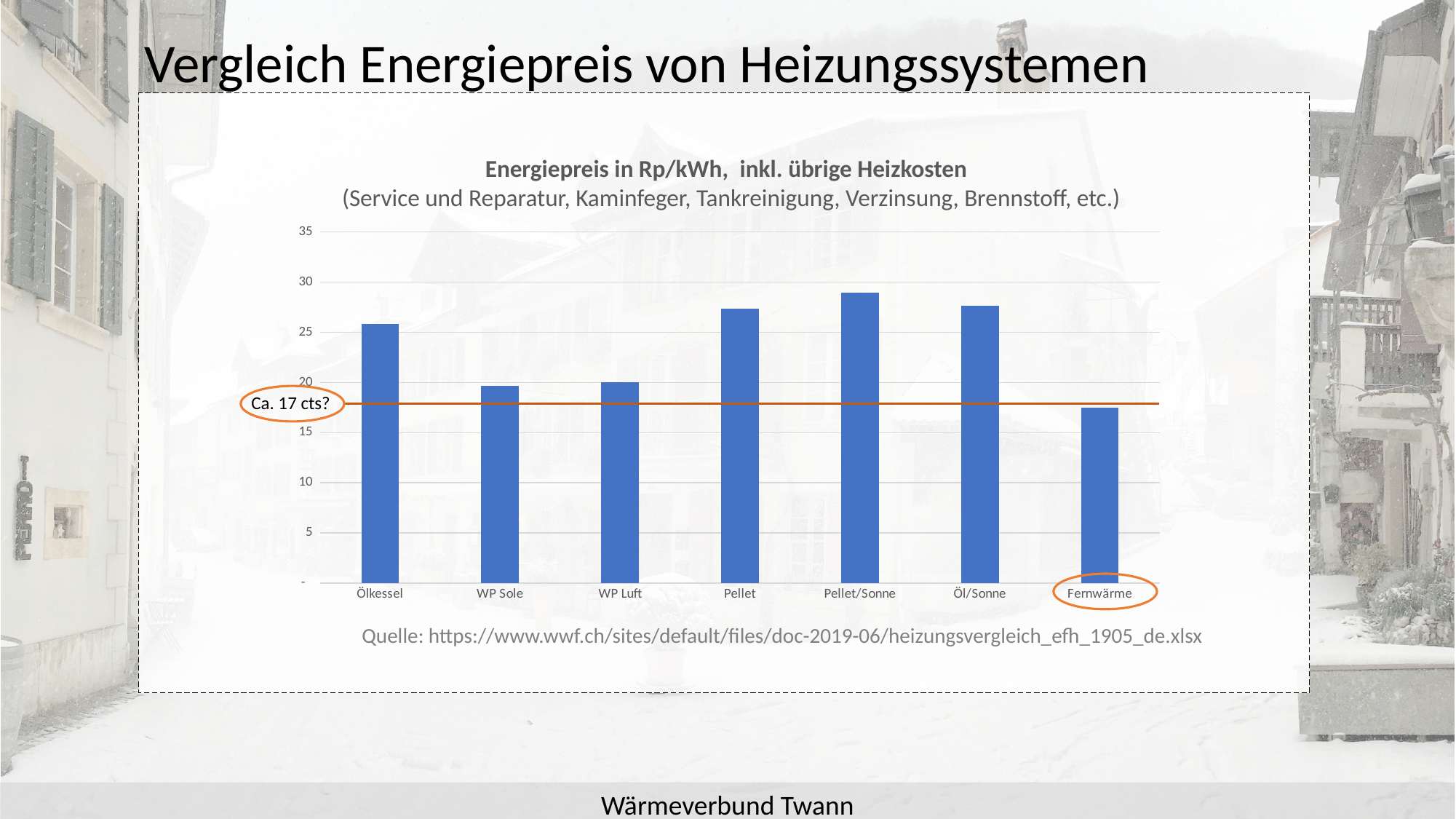
What text is written in the orange oval next to the horizontal line on the chart? Ca. 17 cts? What kind of chart is shown on the slide? bar chart Which has the higher energy price, Ölkessel or WP Sole? Ölkessel Which heating system has the lowest energy price in the chart? Fernwärme Which heating system has the highest energy price in the chart? Pellet/Sonne Is the value for WP Sole greater or less than 15? greater Is the value for Pellet/Sonne greater or less than 30? less Is the value for Fernwärme greater or less than 20? less How many heating systems (categories) are shown on the x axis of the chart? 7 Which has the higher energy price, WP Luft or Fernwärme? WP Luft